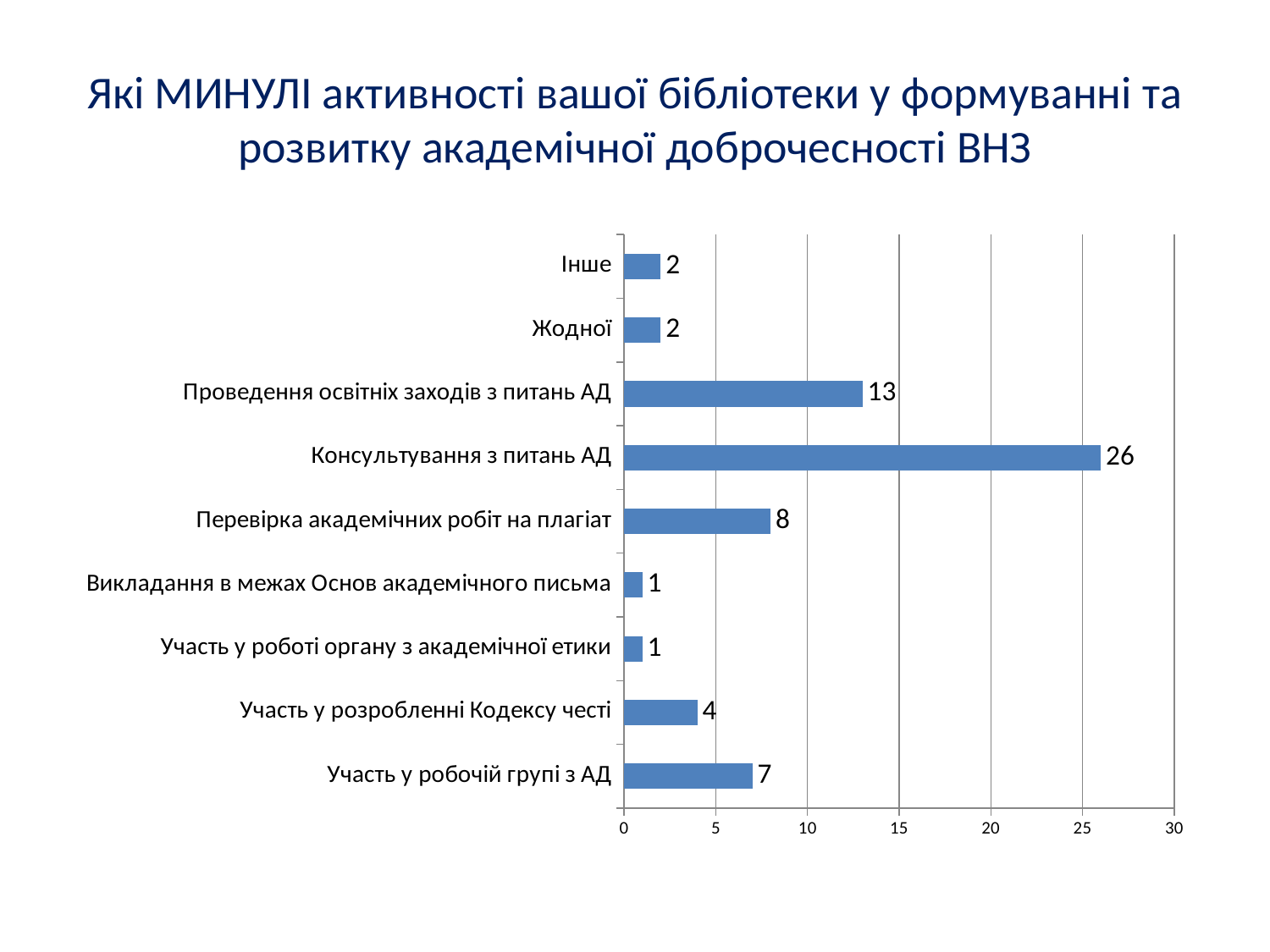
What kind of chart is shown on the slide? bar chart Which category has the highest value? Консультування з питань АД What is the value for Участь у робочій групі з АД? 7 What is the value for Проведення освітніх заходів з питань АД? 13 What is the value for Жодної? 2 What is the difference between Консультування з питань АД and Проведення освітніх заходів з питань АД? 13 What is the value for Перевірка академічних робіт на плагіат? 8 What is the maximum value shown on the horizontal axis? 30 What is the value for Консультування з питань АД? 26 Is the value for Консультування з питань АД greater or less than 25? greater How many categories are shown in the chart? 9 Which is larger: Участь у розробленні Кодексу честі or Участь у робочій групі з АД? Участь у робочій групі з АД